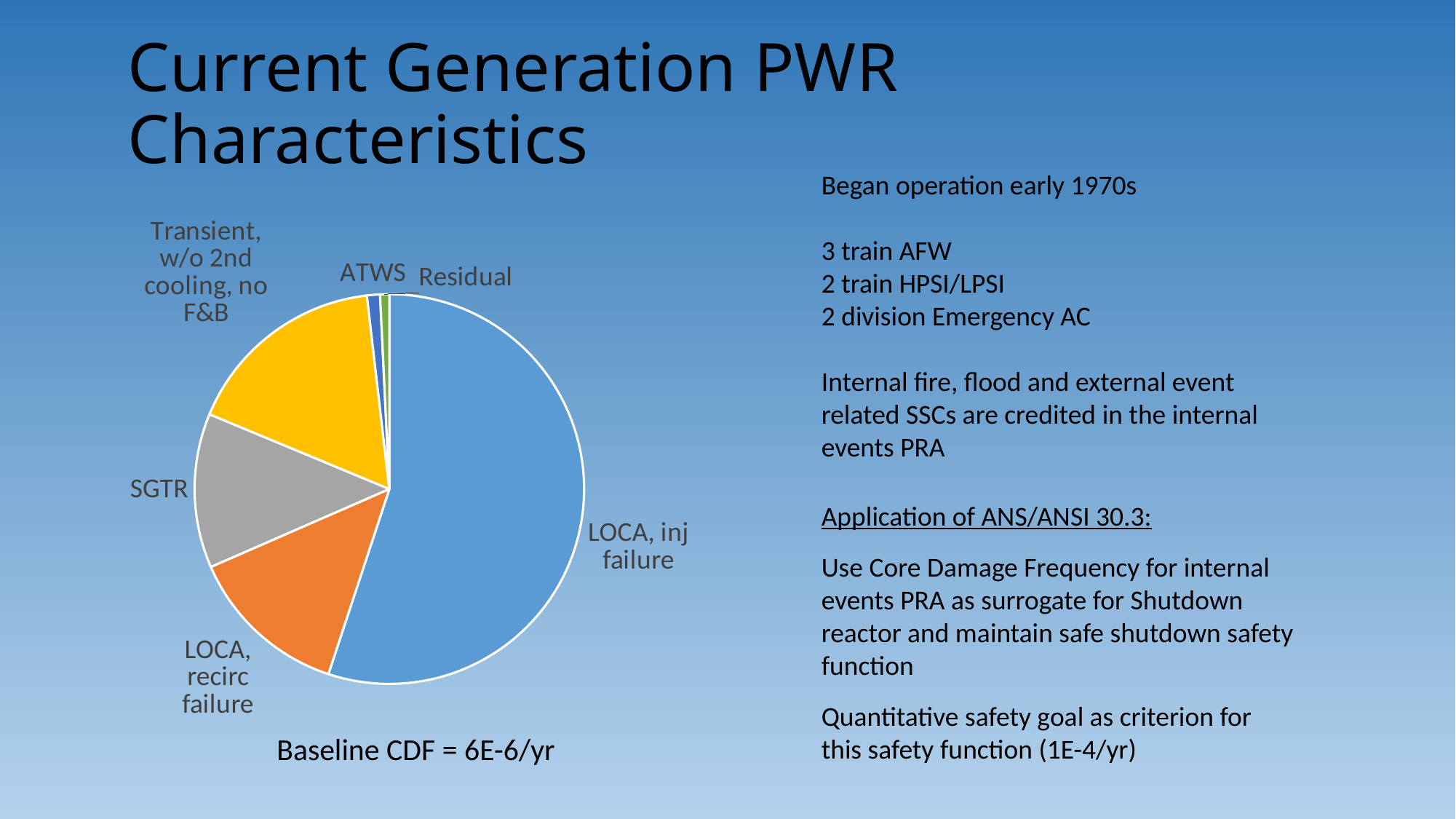
What baseline CDF value is printed below the pie chart? Baseline CDF = 6E-6/yr Which is larger in the pie chart: Transient, w/o 2nd cooling, no F&B or ATWS? Transient, w/o 2nd cooling, no F&B Which is larger in the pie chart: LOCA, inj failure or Transient, w/o 2nd cooling, no F&B? LOCA, inj failure Which category has the largest slice of the pie chart? LOCA, inj failure Does the LOCA, inj failure slice account for more or less than half of the pie? more What kind of chart is shown on the slide? Pie chart Which is larger in the pie chart: LOCA, recirc failure or Residual? LOCA, recirc failure What colour is the LOCA, inj failure slice in the pie chart? Blue How many slices (categories) does the pie chart have? 6